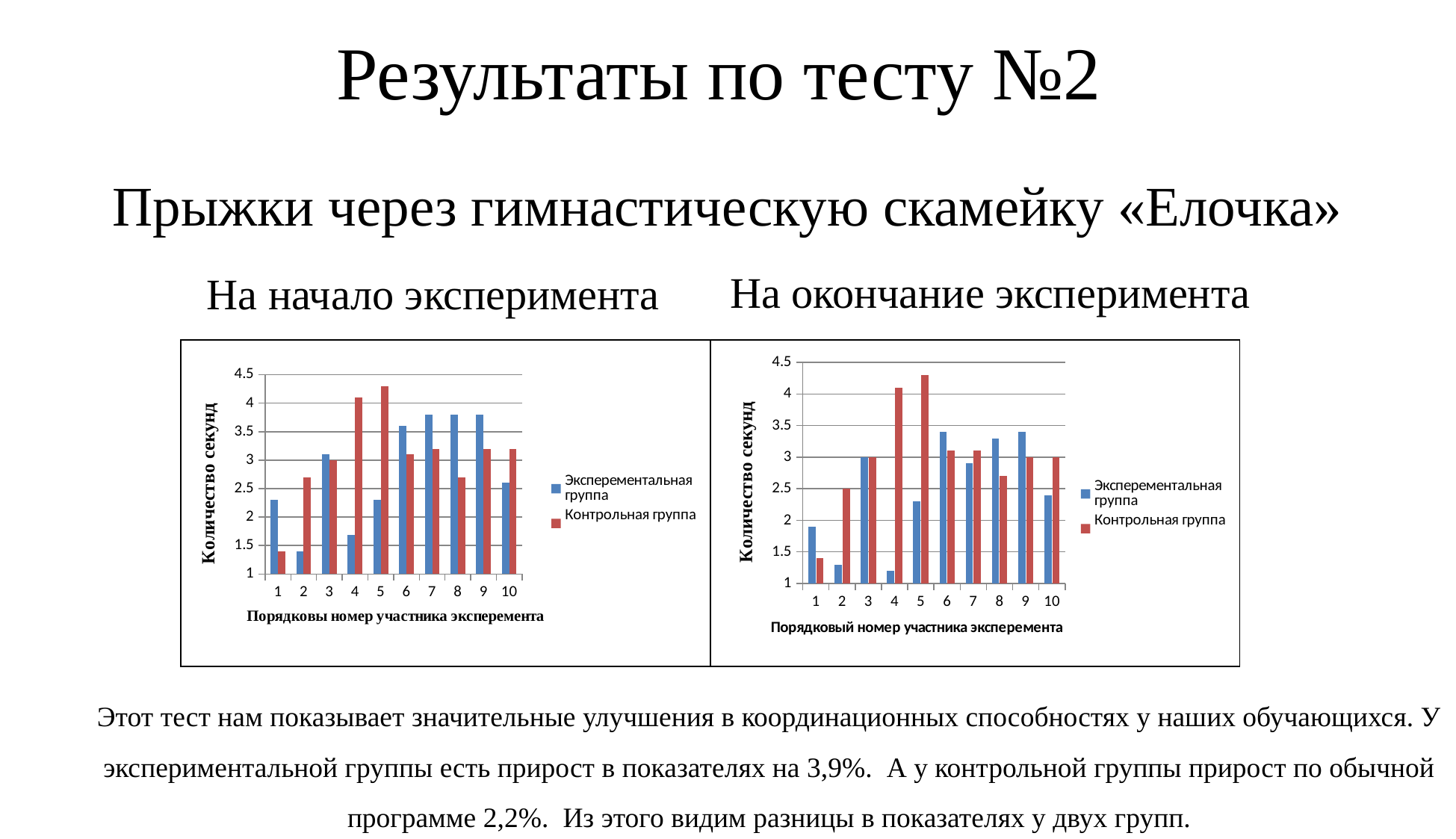
What kind of chart is shown under "На начало эксперимента"? bar chart In the "На начало эксперимента" chart, is the value for Эксперементальная группа for participant 4 greater or less than 2? less In the "На окончание эксперимента" chart, which participant has the highest value for Контрольная группа? 5 In the "На начало эксперимента" chart, how many participants are shown on the x axis? 10 In the "На окончание эксперимента" chart, for participant 1, which group has the larger value? Эксперементальная группа In the "На начало эксперимента" chart, is the value for Контрольная группа for participant 5 greater or less than 4? greater In the "На окончание эксперимента" chart, how many series does the legend list? 2 In the "На окончание эксперимента" chart, is the value for Эксперементальная группа for participant 4 greater or less than 1.5? less In the "На окончание эксперимента" chart, what is the value for Контрольная группа for participant 2? 2.5 What is the y-axis label of the "На начало эксперимента" chart? Количество секунд In the "На начало эксперимента" chart, for participant 4, which group has the larger value? Контрольная группа In the "На начало эксперимента" chart, what is the value for Контрольная группа for participant 3? 3